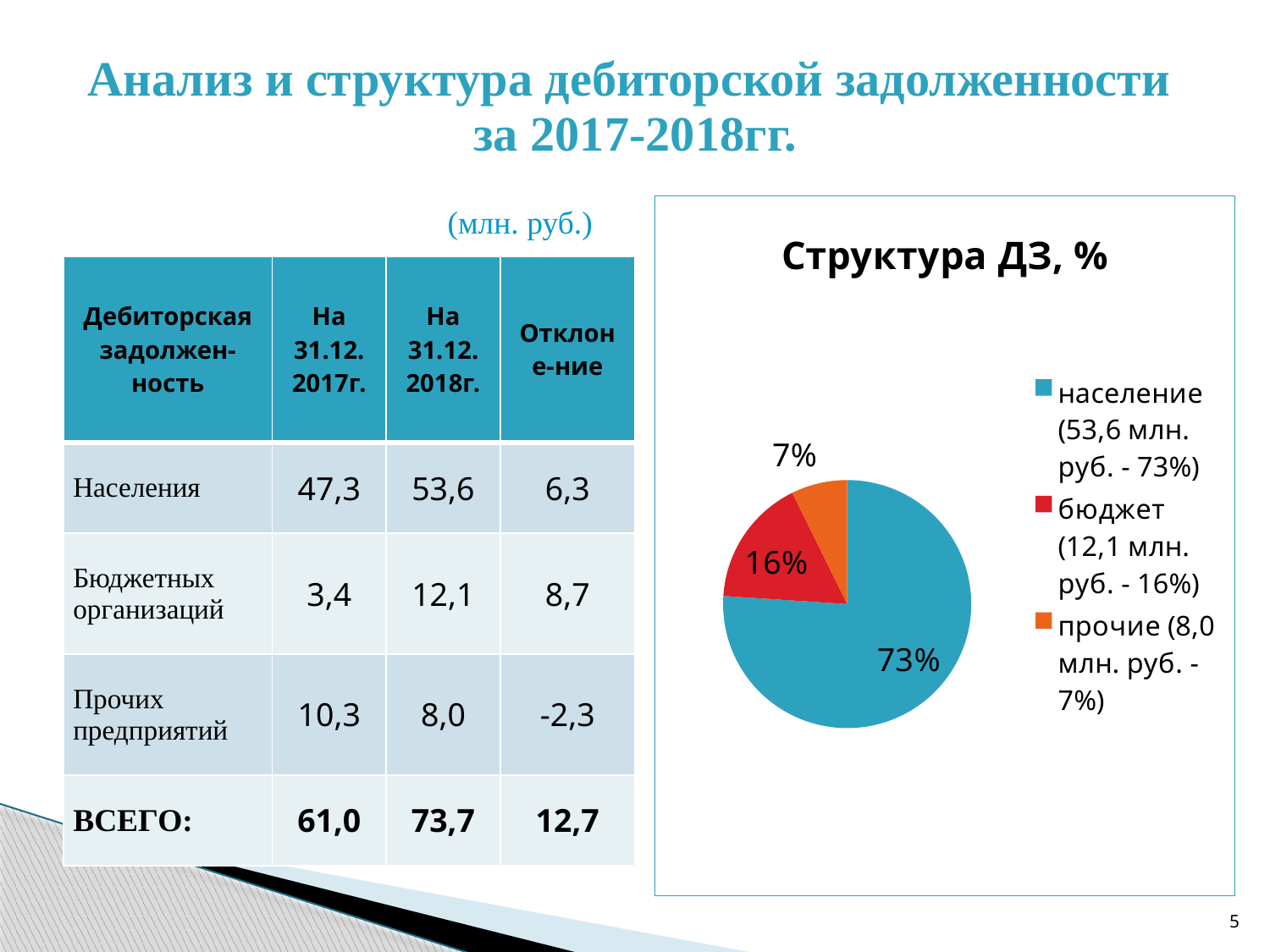
Which slice of the pie chart is the largest? население What is the difference in percentage points between the 'население' and 'бюджет' slices? 57 Which slice is larger, 'бюджет' or 'прочие'? бюджет What kind of chart is shown on the slide? pie chart What share of the pie does the 'прочие' slice have? 7% What share of the pie does the 'бюджет' slice have? 16% What is the title of the chart? Структура ДЗ, % What share of the pie does the 'население' slice have? 73% How many entries does the chart legend list? 3 According to the legend, what amount in млн. руб. corresponds to the 'бюджет' slice? 12,1 млн. руб. How many slices does the pie chart have? 3 Which slice of the pie chart is the smallest? прочие